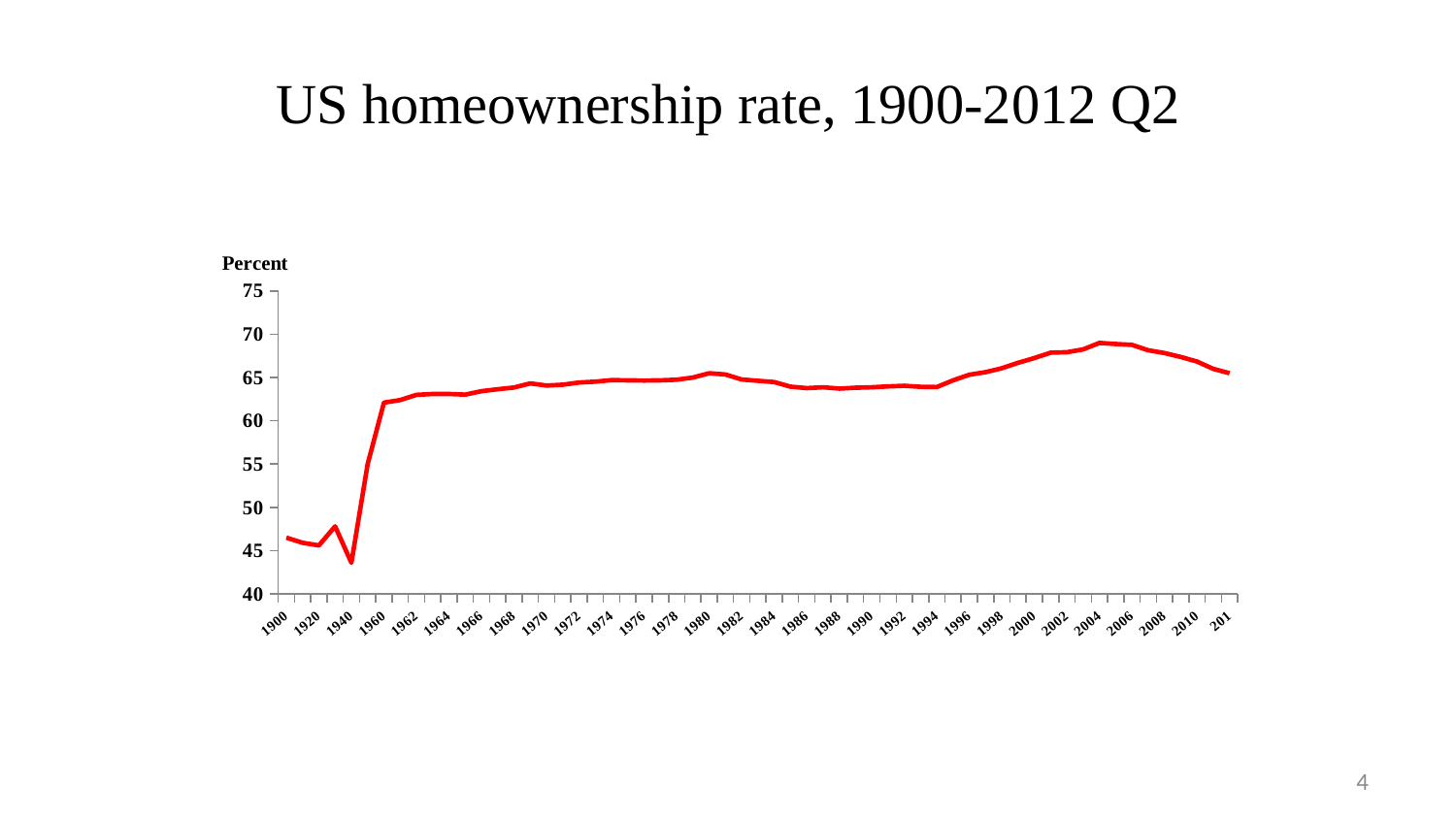
What is the title of the chart? US homeownership rate, 1900-2012 Q2 Is the homeownership rate in 1960 greater or less than 60? greater Is the homeownership rate in 2004 greater or less than 70? less Does the homeownership rate rise or fall between 1940 and 1960? rise Is the homeownership rate in 1940 greater or less than 45? less In which labelled year does the homeownership rate reach its lowest point? 1940 What kind of chart is shown on the slide? line chart Does the homeownership rate rise or fall between 2004 and 2012? fall In which labelled year does the homeownership rate reach its highest point? 2004 Which is larger, the homeownership rate in 1900 or in 2000? 2000 What label is shown on the vertical axis of the chart? Percent